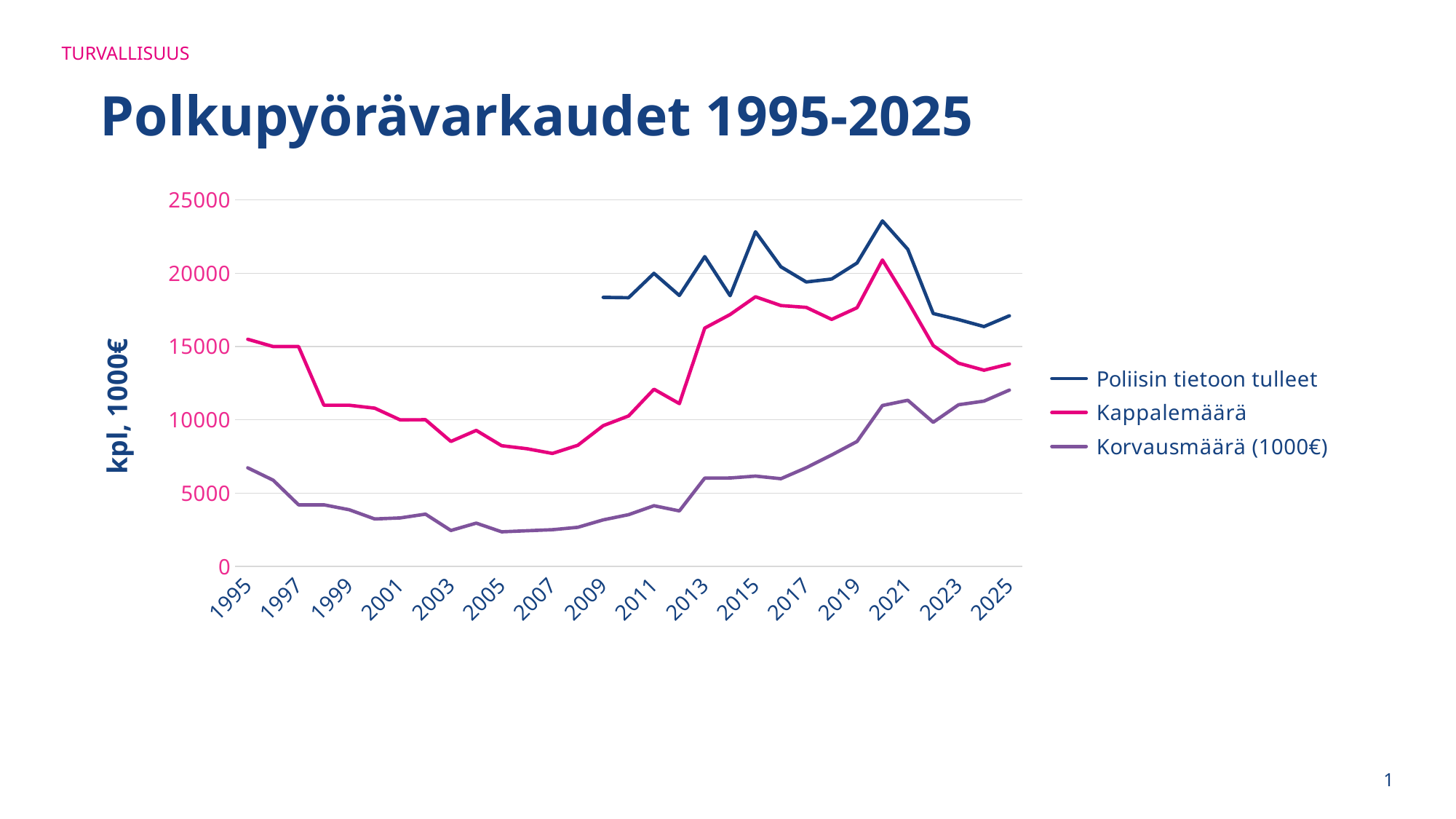
In which year does the Poliisin tietoon tulleet series reach its highest value? 2020 How many series does the legend list? 3 In which year does the Kappalemäärä series reach its highest value? 2020 In which year is the Kappalemäärä series at its lowest? 2007 Does the Korvausmäärä (1000€) series generally rise or fall from 2013 to 2025? rise Is the value for Korvausmäärä (1000€) in 2025 greater or less than 10000? greater What kind of chart is shown on the slide? line chart In 2025, which is larger: Poliisin tietoon tulleet or Kappalemäärä? Poliisin tietoon tulleet What is the label on the vertical axis? kpl, 1000€ Is the value for Poliisin tietoon tulleet in 2020 greater or less than 20000? greater What is the title of the chart? Polkupyörävarkaudet 1995-2025 Is the value for Kappalemäärä in 2007 greater or less than 10000? less